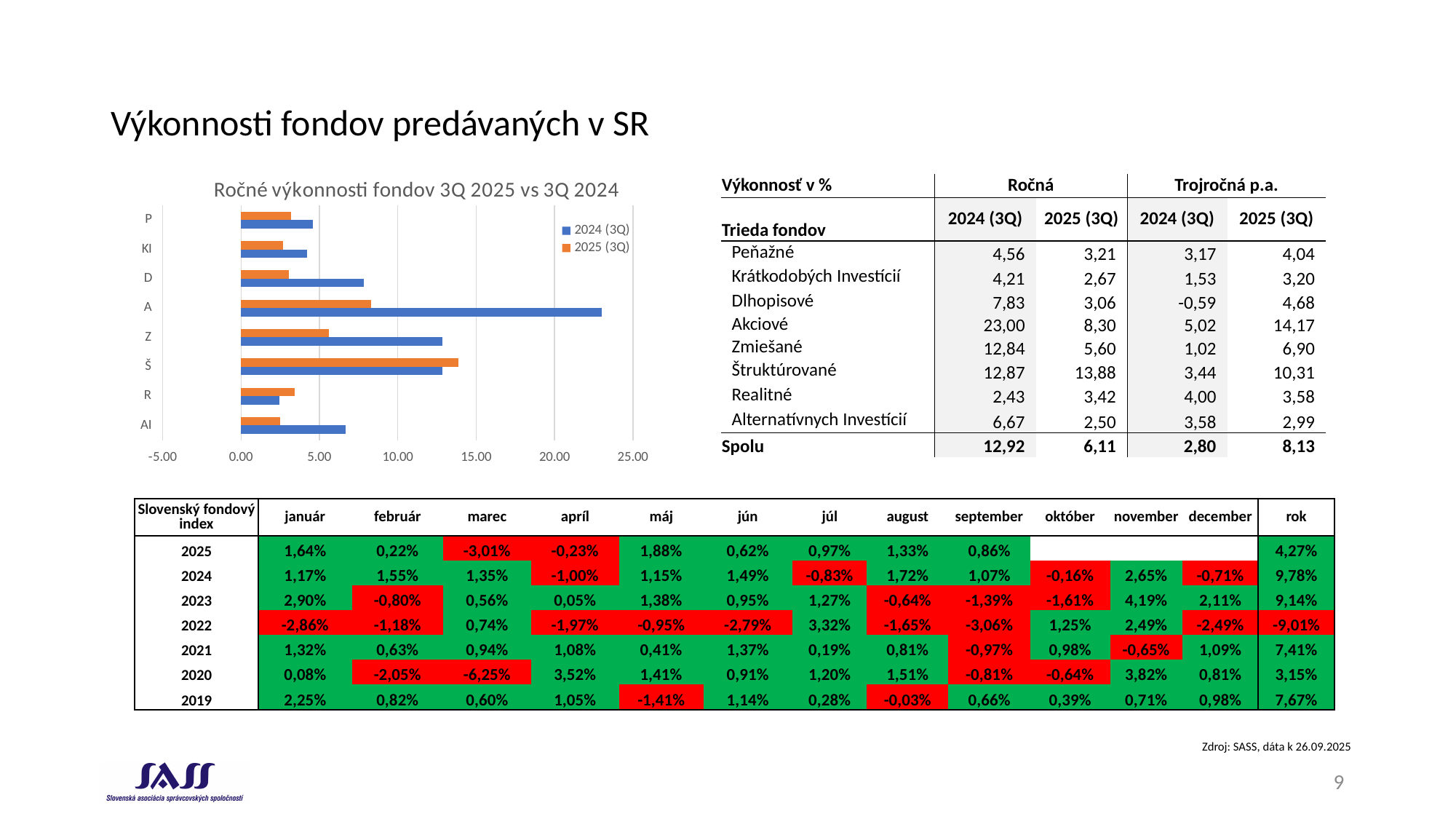
Is the 2024 (3Q) value for A greater or less than 20.00? greater Which category has the lowest value for the 2024 (3Q) series? R How many series does the chart legend list? 2 Which colour represents the 2025 (3Q) series in the chart? orange Is the 2025 (3Q) value for AI greater or less than 5.00? less Is the 2025 (3Q) value for Š greater or less than 10.00? greater What is the title of the chart? Ročné výkonnosti fondov 3Q 2025 vs 3Q 2024 Which category has the highest value for the 2025 (3Q) series? Š For category D, which series has the larger value, 2024 (3Q) or 2025 (3Q)? 2024 (3Q) How many categories are plotted on the chart's vertical axis? 8 What kind of chart is shown on the slide? bar chart Which category has the highest value for the 2024 (3Q) series? A